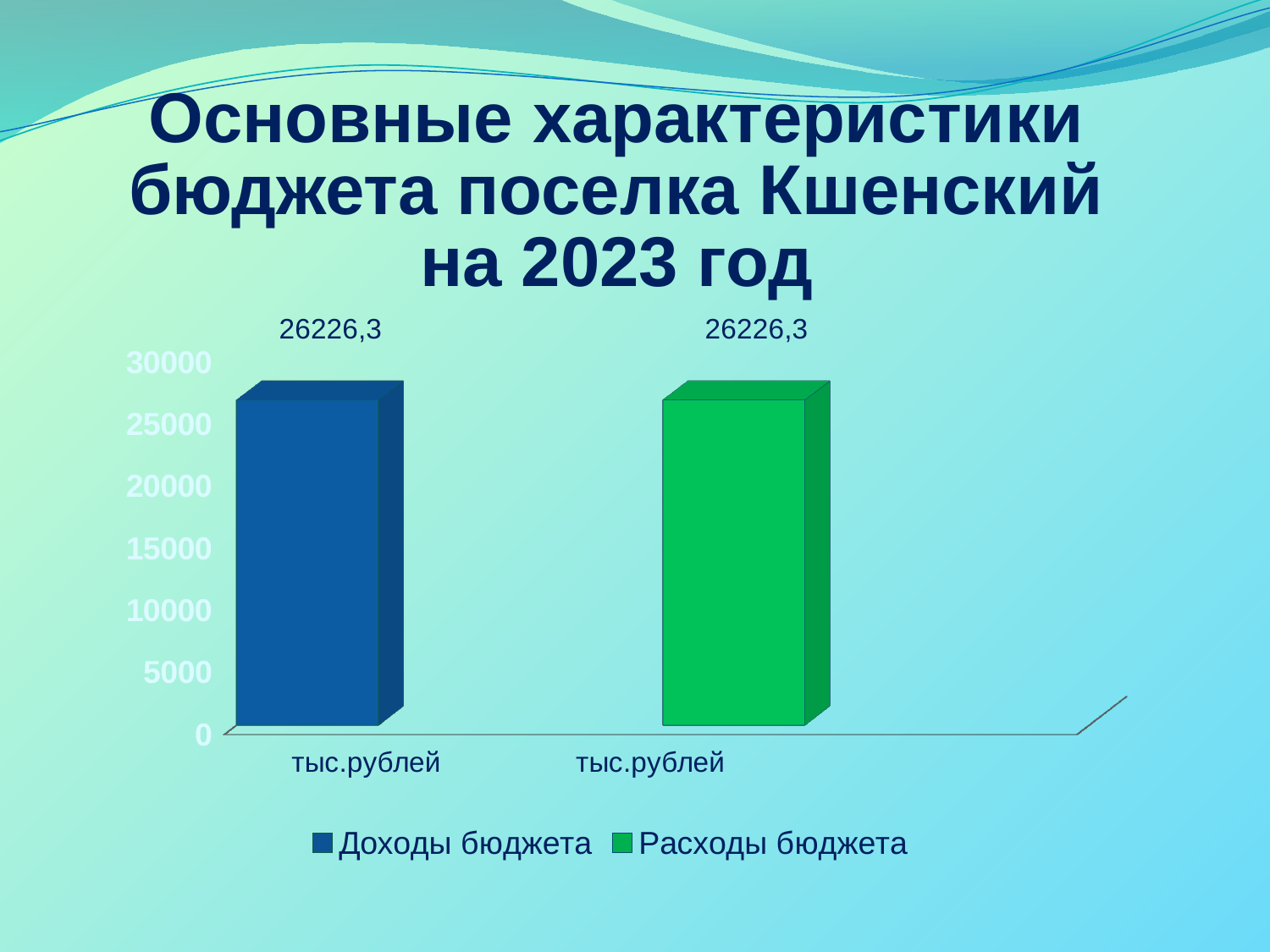
What is the highest value labelled on the vertical axis? 30000 What is the value shown for Расходы бюджета? 26226,3 Which colour represents Расходы бюджета in the legend? green Is the value for Доходы бюджета greater or less than 25000? greater Is the value for Расходы бюджета greater or less than 30000? less What is the value shown for Доходы бюджета? 26226,3 How many series does the legend list? 2 What kind of chart is shown on the slide? bar chart How many bars are plotted on the chart? 2 What is the difference between the values for Доходы бюджета and Расходы бюджета? 0